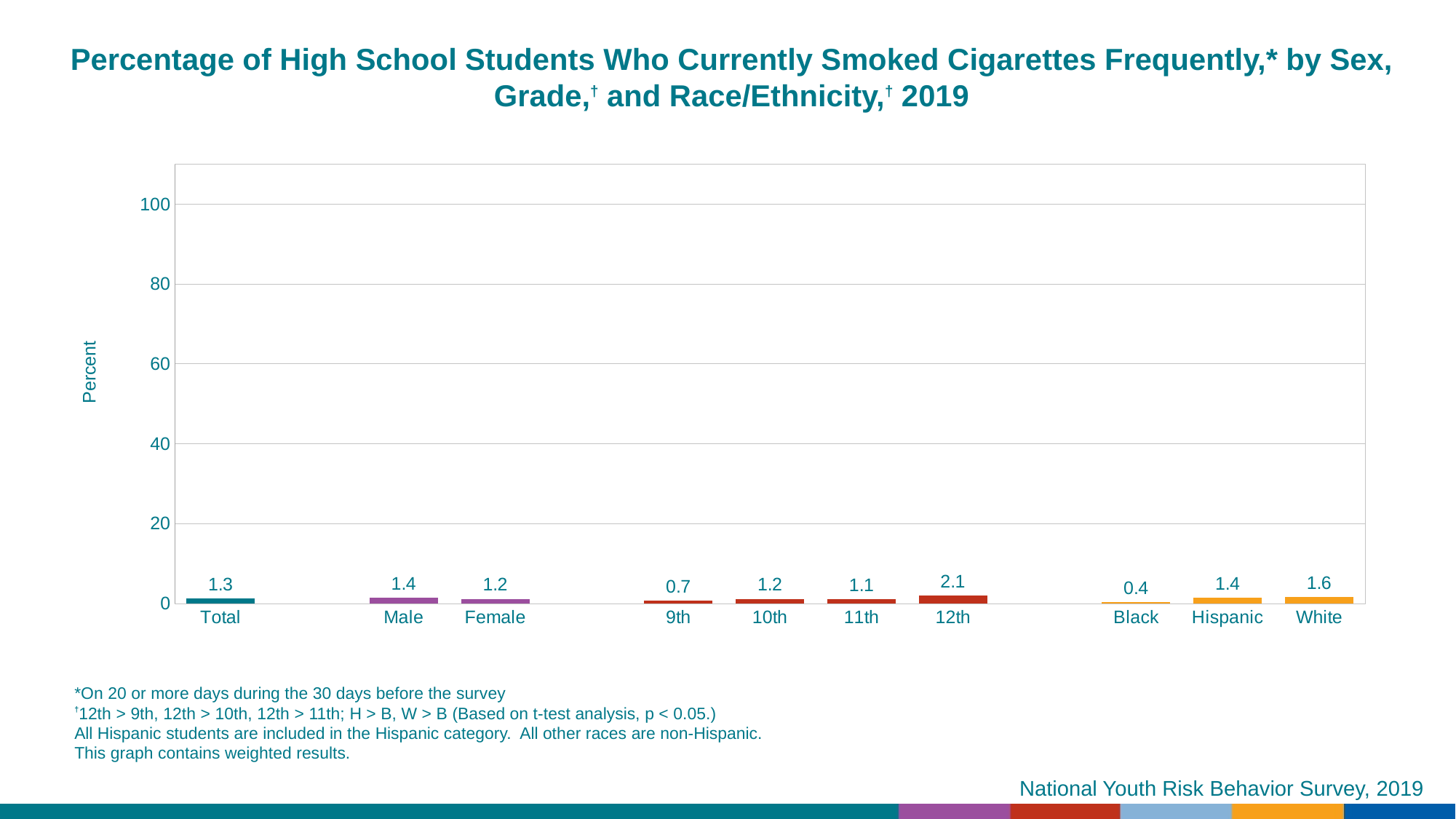
What is the difference between the values for White and Black? 1.2 Which is larger, the value for 9th grade or the value for 11th grade? 11th What is the value for Total? 1.3 Which category has the lowest value? Black What is the value for 12th grade students? 2.1 Which category has the highest value? 12th Is the value for Hispanic greater or less than 20? less How many categories are shown on the x axis? 10 What is the difference between the values for Male and Female? 0.2 What kind of chart is this? bar chart What is the value for Black students? 0.4